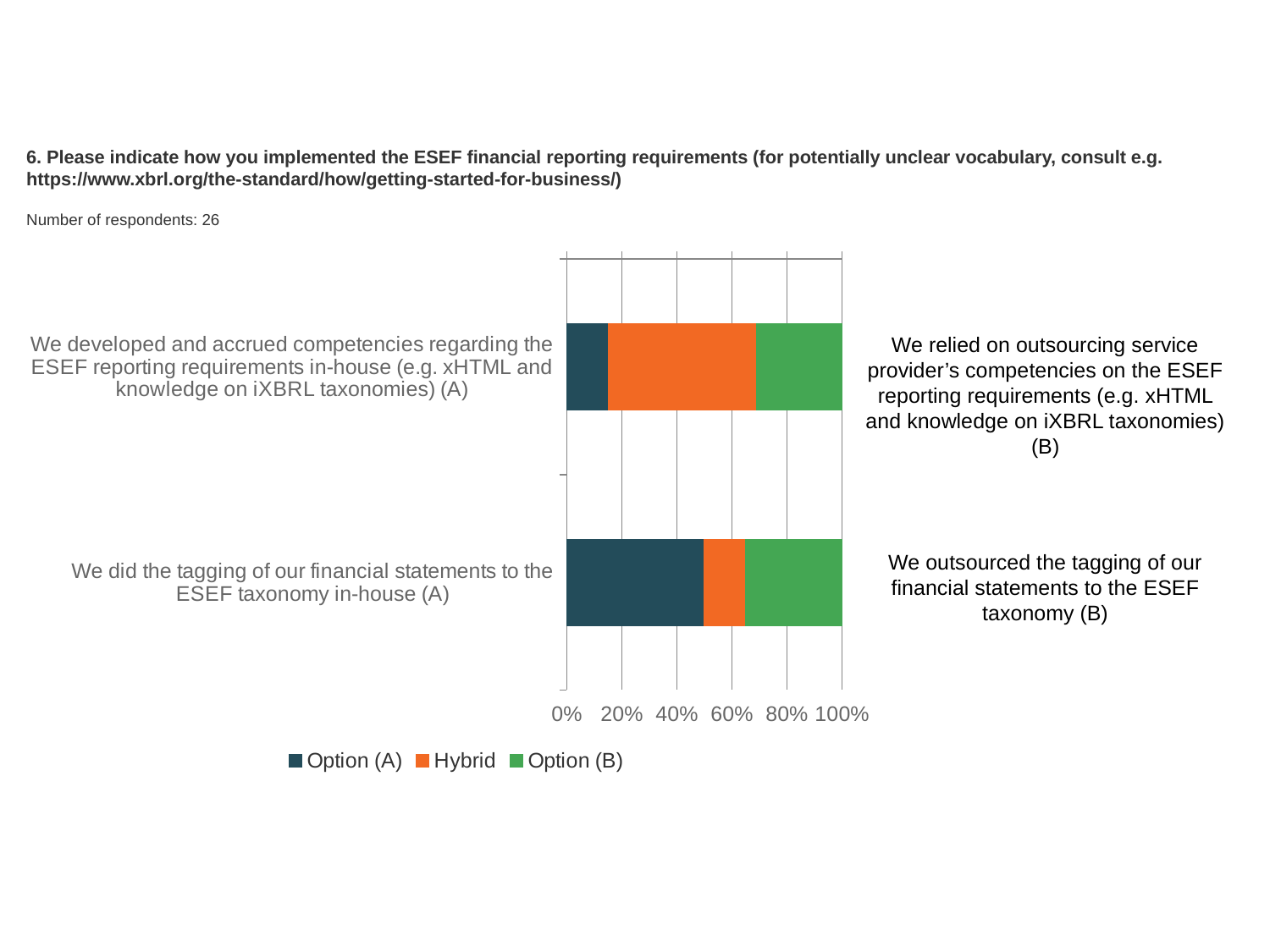
Is the Hybrid share larger in the bar about developing competencies or in the bar about tagging financial statements? Developing competencies Which series has the largest segment in the bar for tagging financial statements in-house (A) versus outsourcing the tagging (B)? Option (A) What kind of chart is shown on the slide? Stacked bar chart Is the Option (A) share in the bar about developing ESEF competencies in-house greater or less than 20%? less How many categories (bars) are plotted in the chart? 2 Is the Hybrid share in the bar about developing ESEF competencies in-house greater or less than 40%? greater Is the Option (A) share in the bar about tagging financial statements greater or less than 40%? greater Is the Option (A) share larger in the bar about tagging financial statements or in the bar about developing competencies? Tagging financial statements What colour represents the Hybrid series in the chart? Orange Which series has the largest segment in the bar for developing competencies in-house (A) versus relying on an outsourcing provider (B)? Hybrid How many series does the legend list? 3